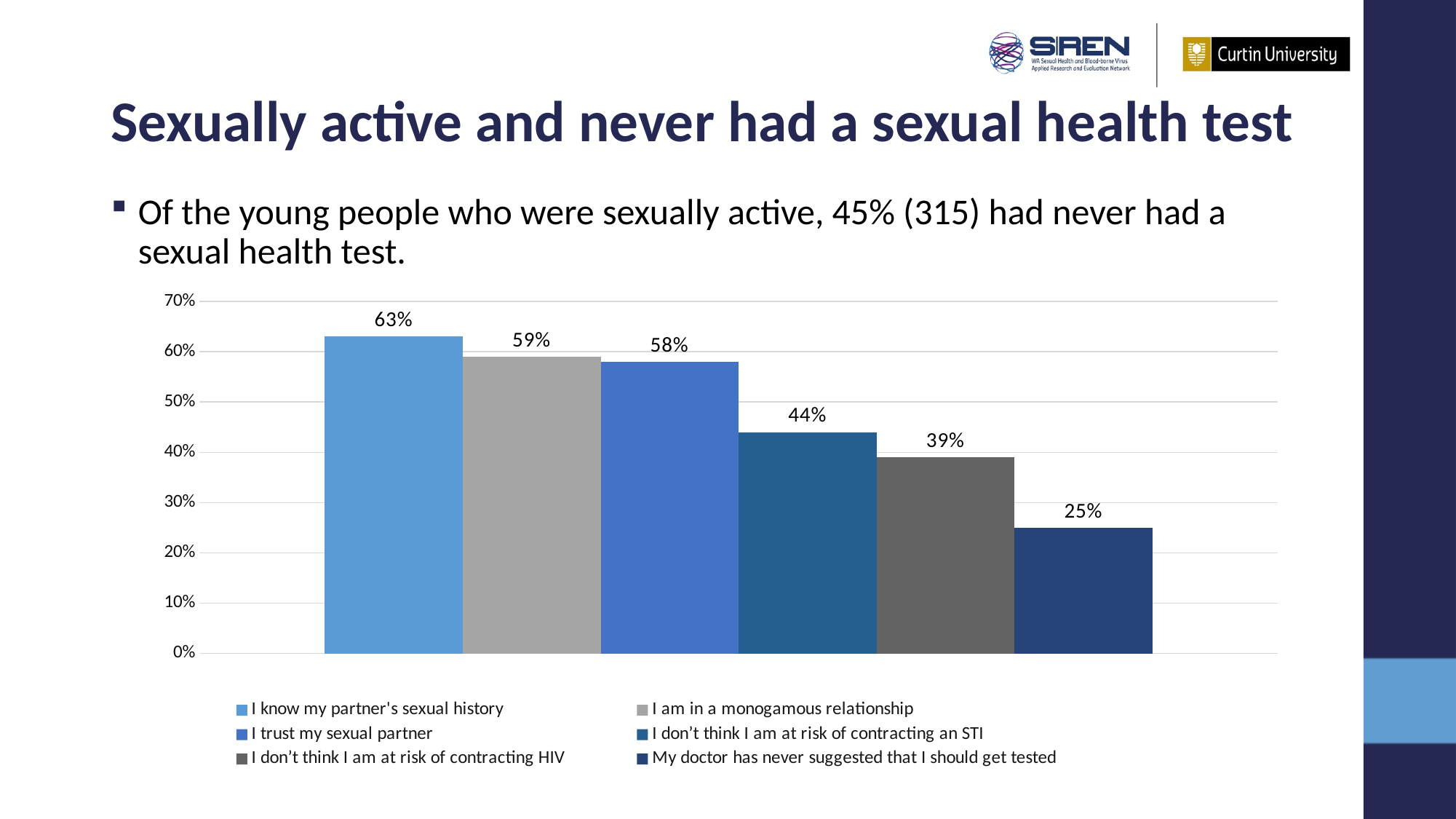
Which reason has the highest percentage? I know my partner's sexual history Do the bar values rise or fall from left to right? Fall How many bars are plotted in the chart? 6 What percentage is shown for "My doctor has never suggested that I should get tested"? 25% What percentage is shown for "I don't think I am at risk of contracting an STI"? 44% What percentage is shown for "I am in a monogamous relationship"? 59% What is the difference between the percentages for "I trust my sexual partner" and "I don't think I am at risk of contracting HIV"? 19% What kind of chart is shown on the slide? Bar chart How many entries does the legend list? 6 Which reason has the lowest percentage? My doctor has never suggested that I should get tested Which is larger: the percentage for "I don't think I am at risk of contracting an STI" or for "I don't think I am at risk of contracting HIV"? I don't think I am at risk of contracting an STI What percentage is shown for "I know my partner's sexual history"? 63%